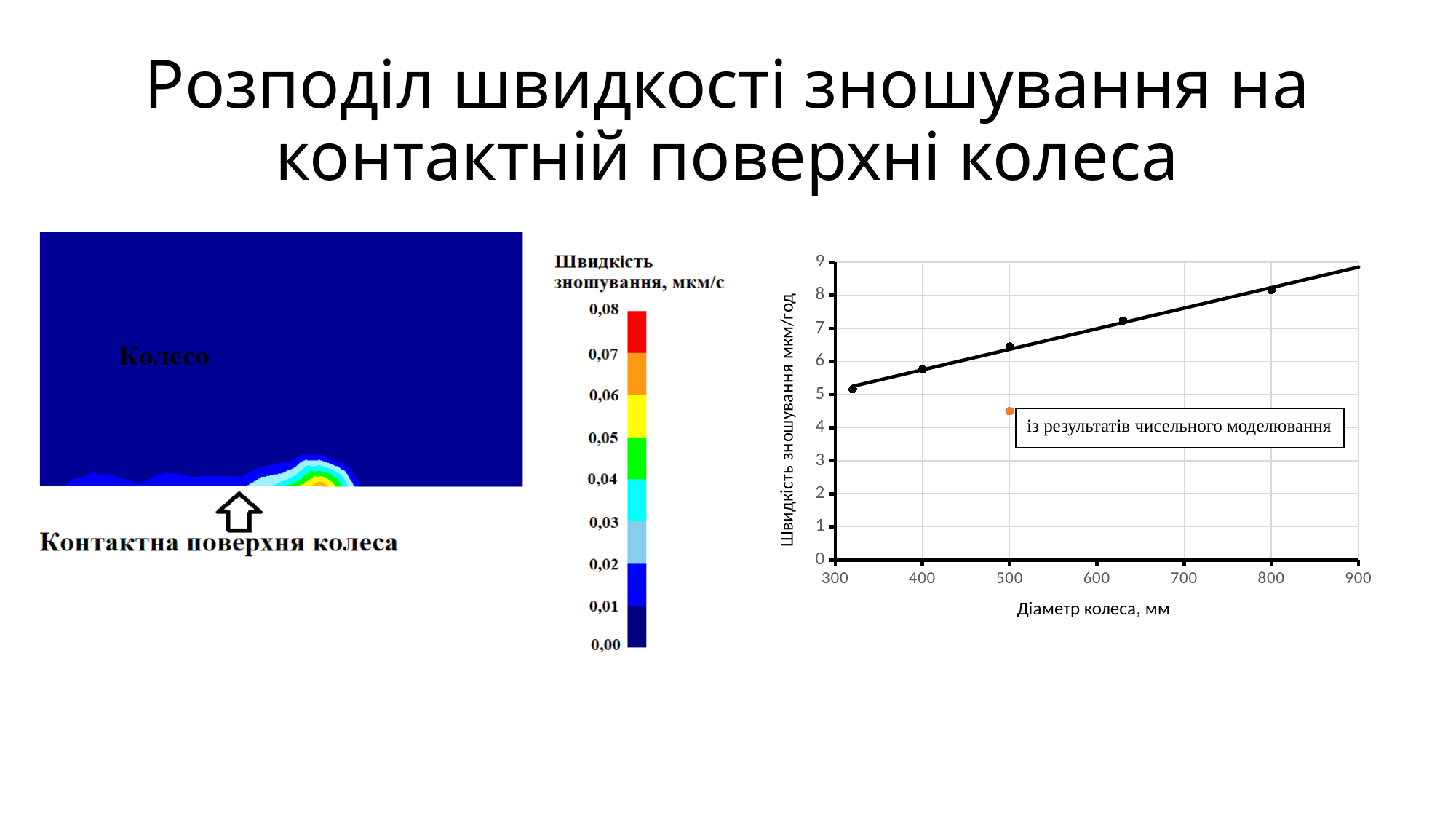
In the chart on the right, is the wear rate for the orange point at a diameter of 500 mm greater or less than 5? less What kind of chart is shown on the right side of the slide? scatter chart with a trend line In the chart on the right, at a diameter of 500 mm, which point has the larger wear rate: the black point or the orange point? the black point In the chart on the right, how many black data points are plotted? 5 In the chart on the right, is the wear rate for the leftmost black point greater or less than 6? less What is the x-axis title of the chart on the right? Діаметр колеса, мм In the chart on the right, is the wear rate for the black point at a diameter of 500 mm greater or less than 6? greater In the chart on the right, what label is attached to the orange point? із результатів чисельного моделювання In the chart on the right, at which wheel diameter is the black point with the highest wear rate? 800 mm In the chart on the right, do the wear rate values rise or fall as wheel diameter increases? rise